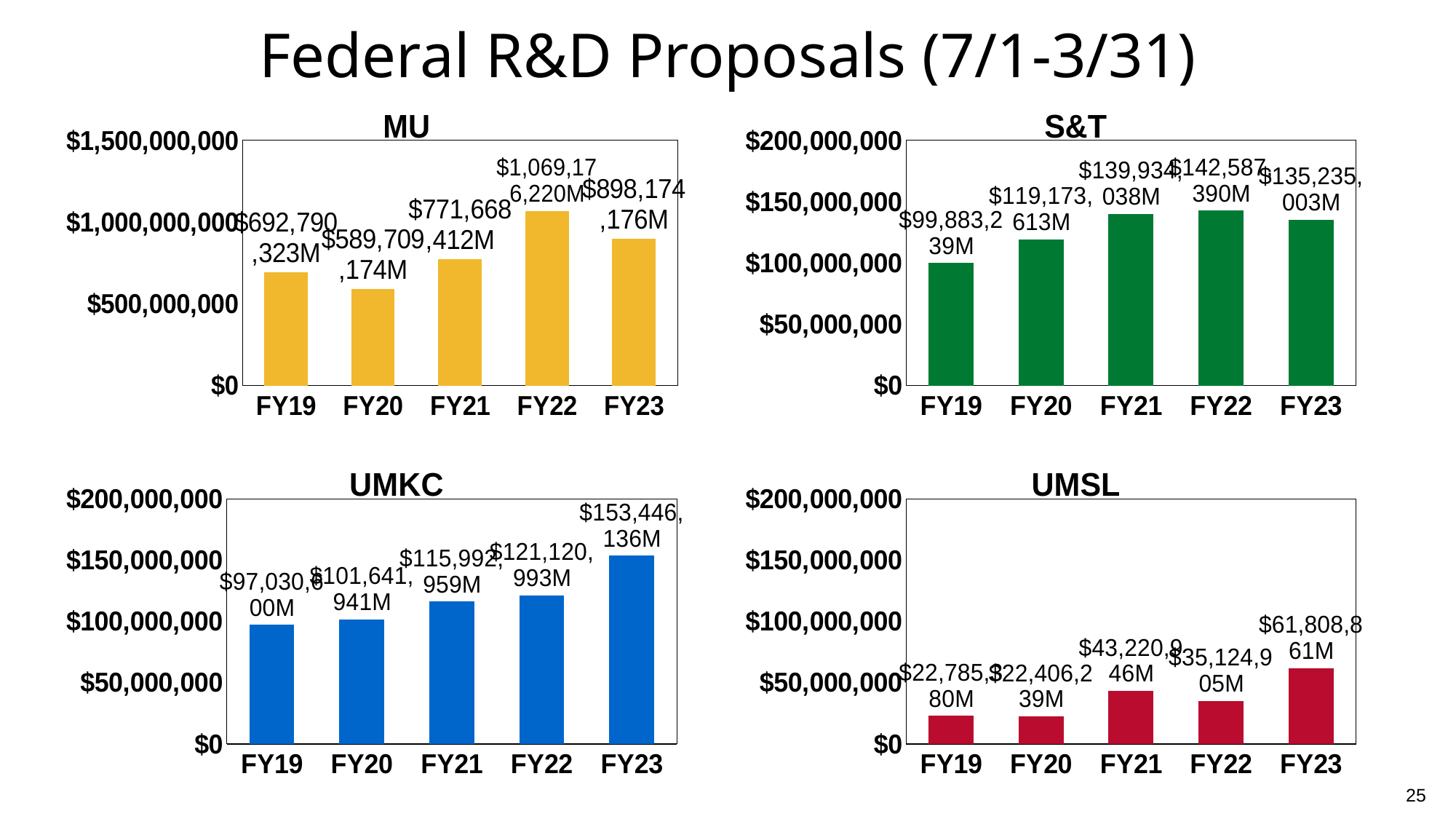
In the S&T chart, what is the value for FY20? $119,173,613M In the UMKC chart, what is the value for FY23? $153,446,136M In the UMSL chart, is the value for FY23 greater or less than $100,000,000? less In the UMSL chart, which is larger, the value for FY21 or the value for FY22? FY21 In the MU chart, which fiscal year has the lowest value? FY20 What kind of chart is the UMSL chart? bar chart In the S&T chart, which fiscal year has the highest value? FY22 In the UMSL chart, what is the value for FY23? $61,808,861M In the UMKC chart, what is the difference between the FY23 and FY22 values? $32,325,143M In the MU chart, what is the value for FY22? $1,069,176,220M How many fiscal years are shown in the S&T chart? 5 In the UMKC chart, do the values rise or fall from FY19 to FY23? rise